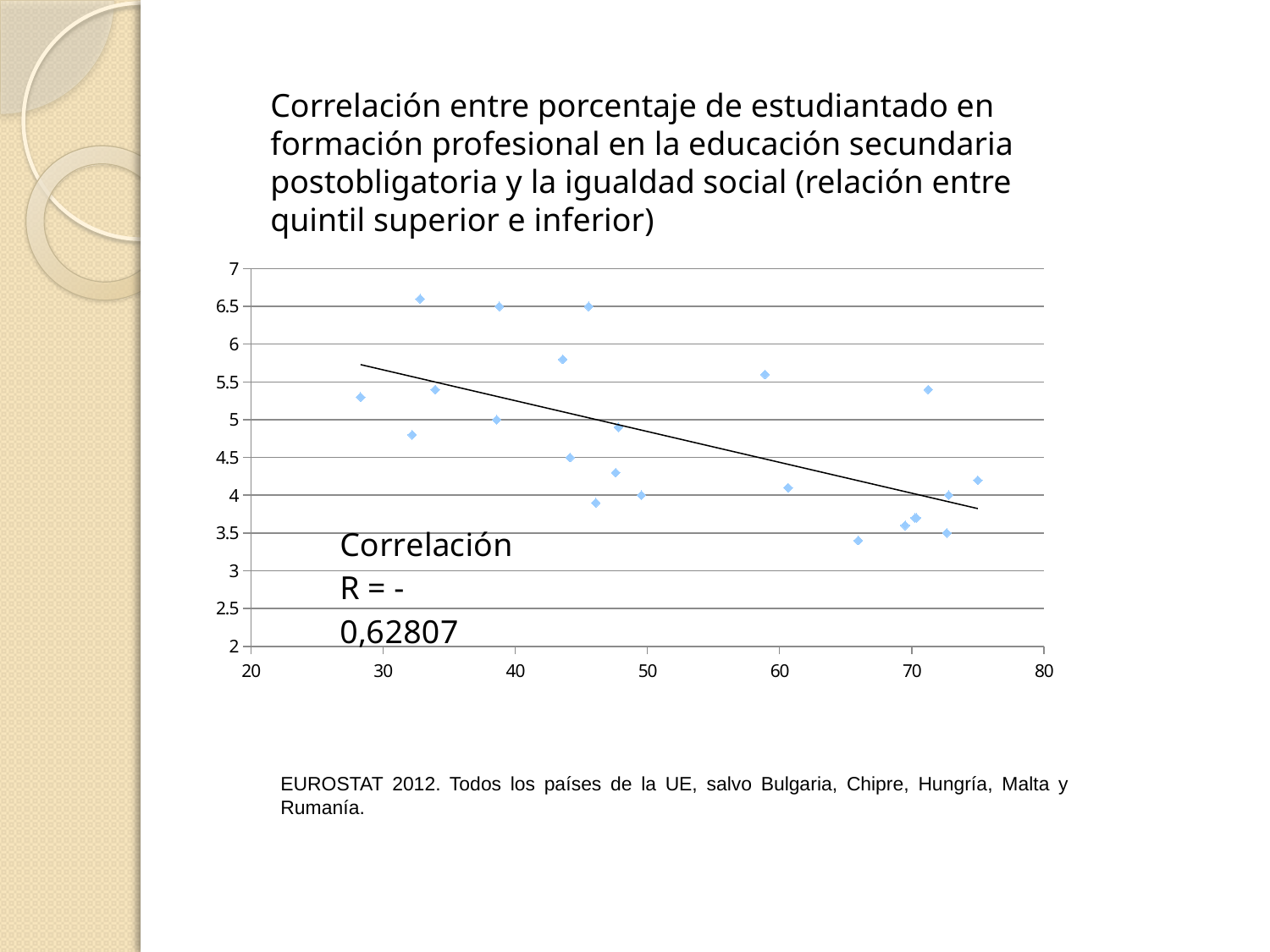
What correlation coefficient R is printed on the chart? -0,62807 Do the values generally rise or fall as the x-axis value increases? fall What is the source cited below the chart? EUROSTAT 2012 Is the y value of the point near x = 59 greater or less than 5? greater Is the y value of the leftmost point (near x = 28) greater or less than 5? greater Does the trend line slope upward or downward from left to right? downward How many data points are plotted in the scatter chart? 23 Is the y value of the point near x = 66 greater or less than 4? less What kind of chart is shown on the slide? scatter chart